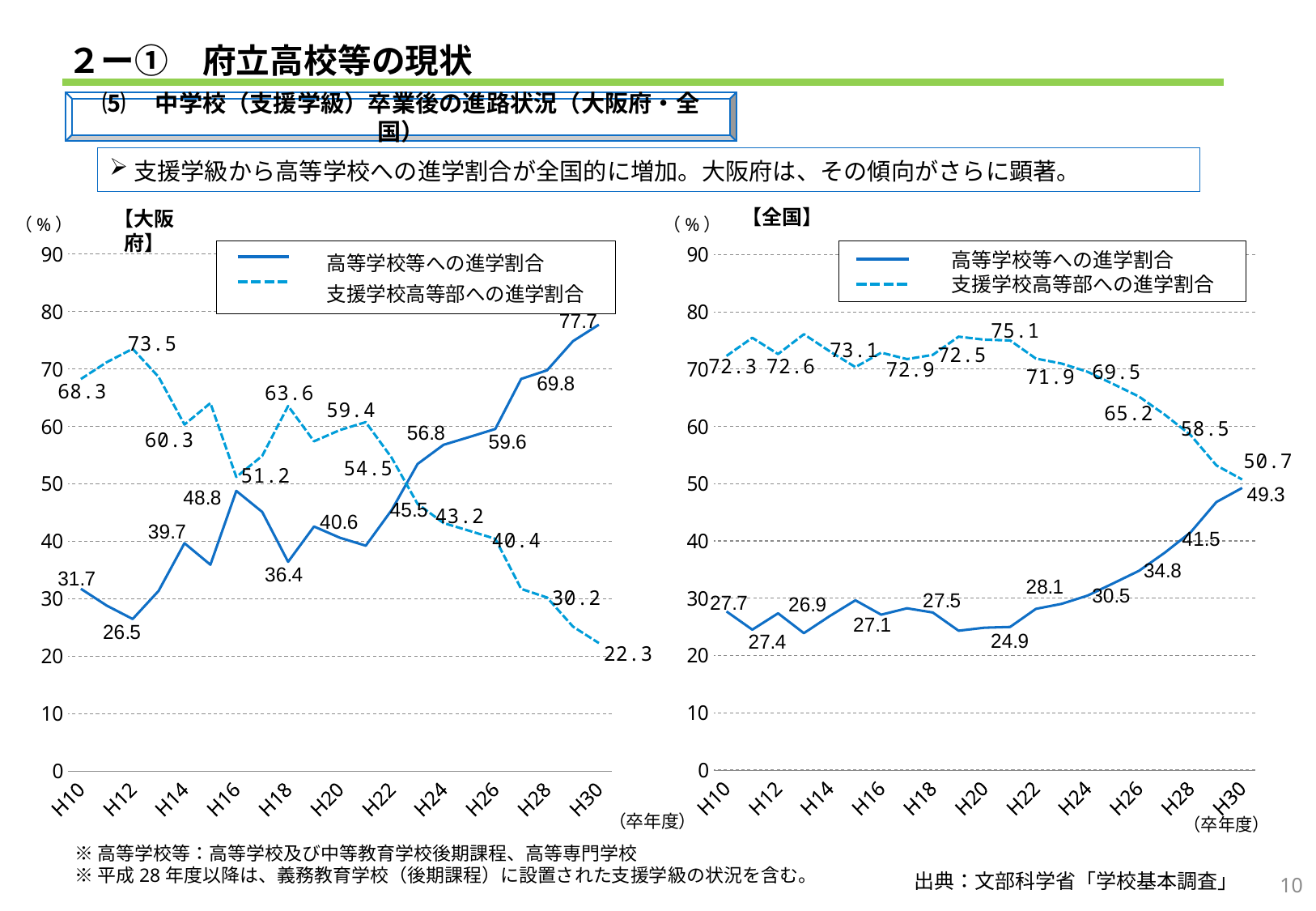
In the 【全国】 chart, what is the value of 支援学校高等部への進学割合 for H20? 75.1 In the 【全国】 chart, is the value of 高等学校等への進学割合 for H20 greater or less than 30? less In the 【全国】 chart, which is larger at H30: 高等学校等への進学割合 or 支援学校高等部への進学割合? 支援学校高等部への進学割合 What kind of chart is the 【全国】 chart? line chart In the 【大阪府】 chart, what is the value of 高等学校等への進学割合 for H30? 77.7 In the 【大阪府】 chart, what is the difference between the H30 and H10 values of 高等学校等への進学割合? 46.0 In the 【全国】 chart, does 支援学校高等部への進学割合 rise or fall from H20 to H30? fall In the 【全国】 chart, which year has the highest labelled value for 支援学校高等部への進学割合? H20 How many series does the legend of the 【大阪府】 chart list? 2 In the 【大阪府】 chart, which year has the lowest labelled value for 高等学校等への進学割合? H12 In the 【全国】 chart, what is the value of 高等学校等への進学割合 for H10? 27.7 In the 【大阪府】 chart, what is the value of 支援学校高等部への進学割合 for H30? 22.3